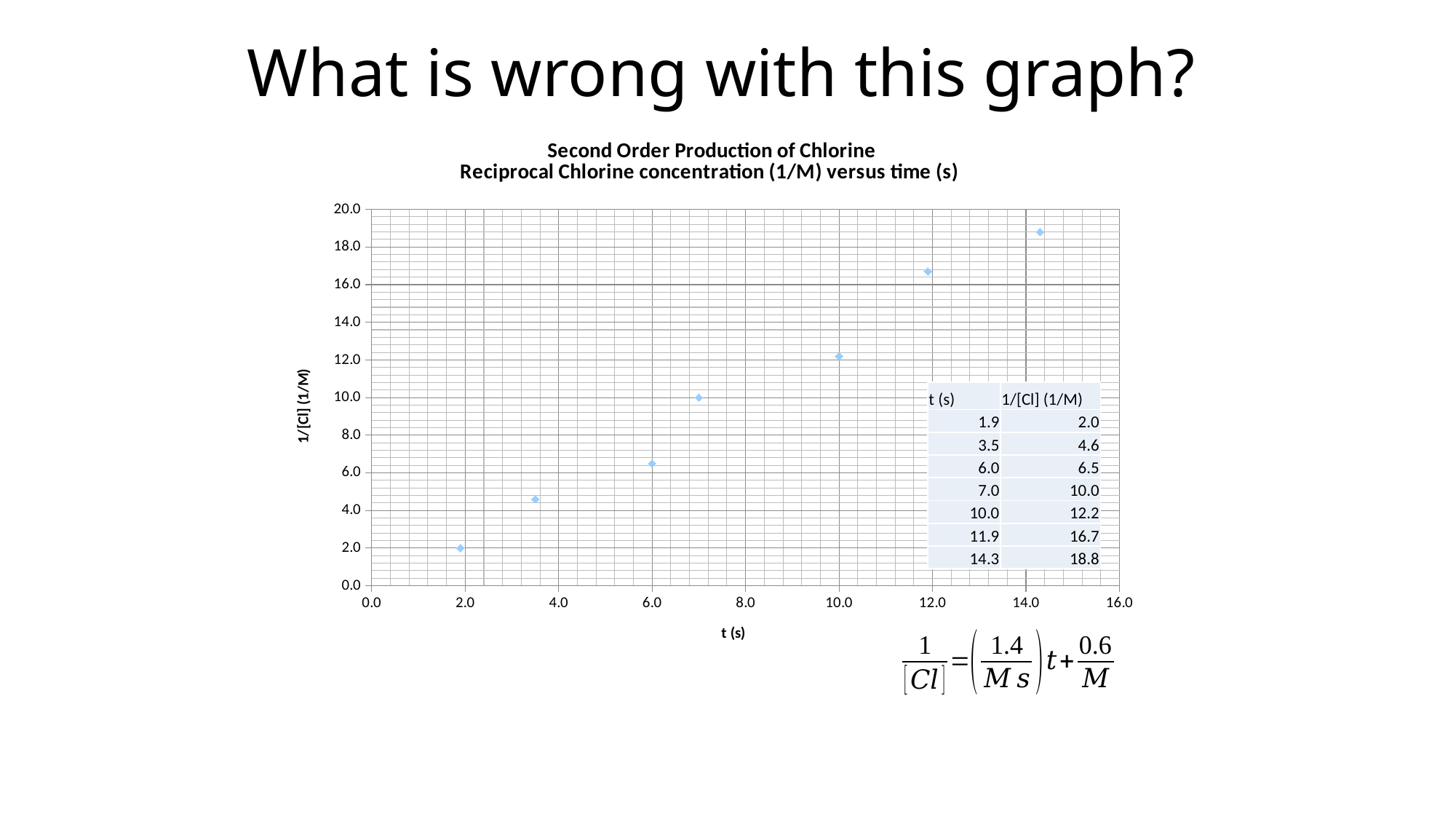
What kind of chart is shown on the slide? scatter chart Which has a larger 1/[Cl] value: the point at t = 10.0 s or the point at t = 6.0 s? t = 10.0 s What is the value of 1/[Cl] (1/M) at t = 7.0 s? 10.0 Is the value of 1/[Cl] at t = 11.9 s greater or less than 14.0? greater What is the label on the x axis of the chart? t (s) At which time t (s) is the value of 1/[Cl] highest? 14.3 What is the value of 1/[Cl] (1/M) at t = 3.5 s? 4.6 At which time t (s) is the value of 1/[Cl] lowest? 1.9 What is the value of 1/[Cl] (1/M) at t = 14.3 s? 18.8 What is the difference between the 1/[Cl] values at t = 14.3 s and t = 1.9 s? 16.8 How many data points are plotted on the chart? 7 Do the values of 1/[Cl] rise or fall as t increases along the x axis? rise